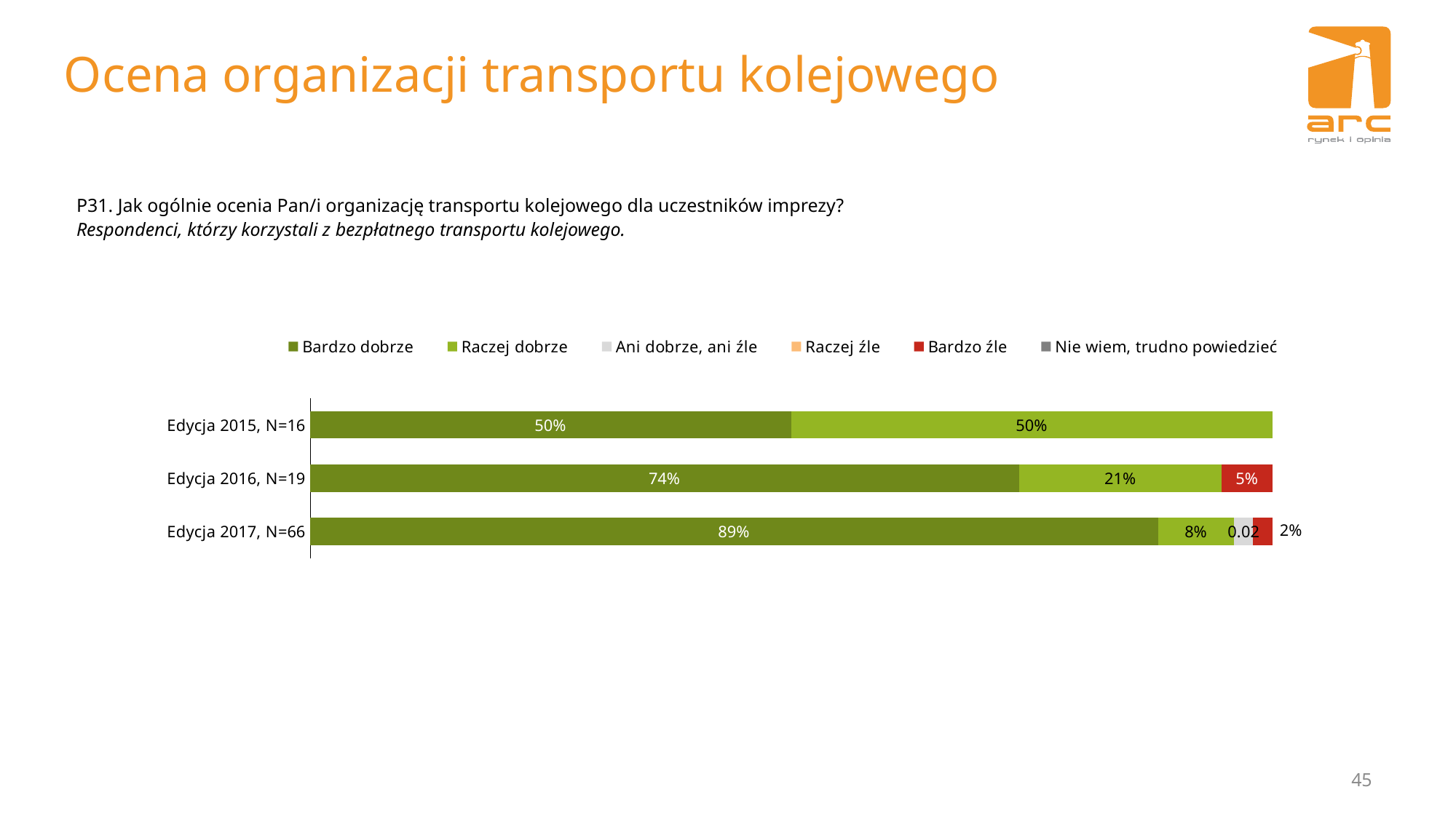
What is the 'Bardzo źle' value for Edycja 2016, N=19? 5% What is the difference between the 'Bardzo dobrze' values for Edycja 2017, N=66 and Edycja 2015, N=16? 39 percentage points How many editions (categories) are plotted on the chart? 3 What is the 'Raczej dobrze' value for Edycja 2017, N=66? 8% What is the 'Bardzo dobrze' value for Edycja 2016, N=19? 74% Does the 'Bardzo dobrze' share rise or fall from Edycja 2015 to Edycja 2017? rise What is the 'Raczej dobrze' value for Edycja 2016, N=19? 21% What is the 'Bardzo dobrze' value for Edycja 2015, N=16? 50% How many series does the legend list? 6 What kind of chart is shown on the slide? stacked bar chart Which edition has the highest 'Bardzo dobrze' share? Edycja 2017, N=66 What is the 'Bardzo dobrze' value for Edycja 2017, N=66? 89%